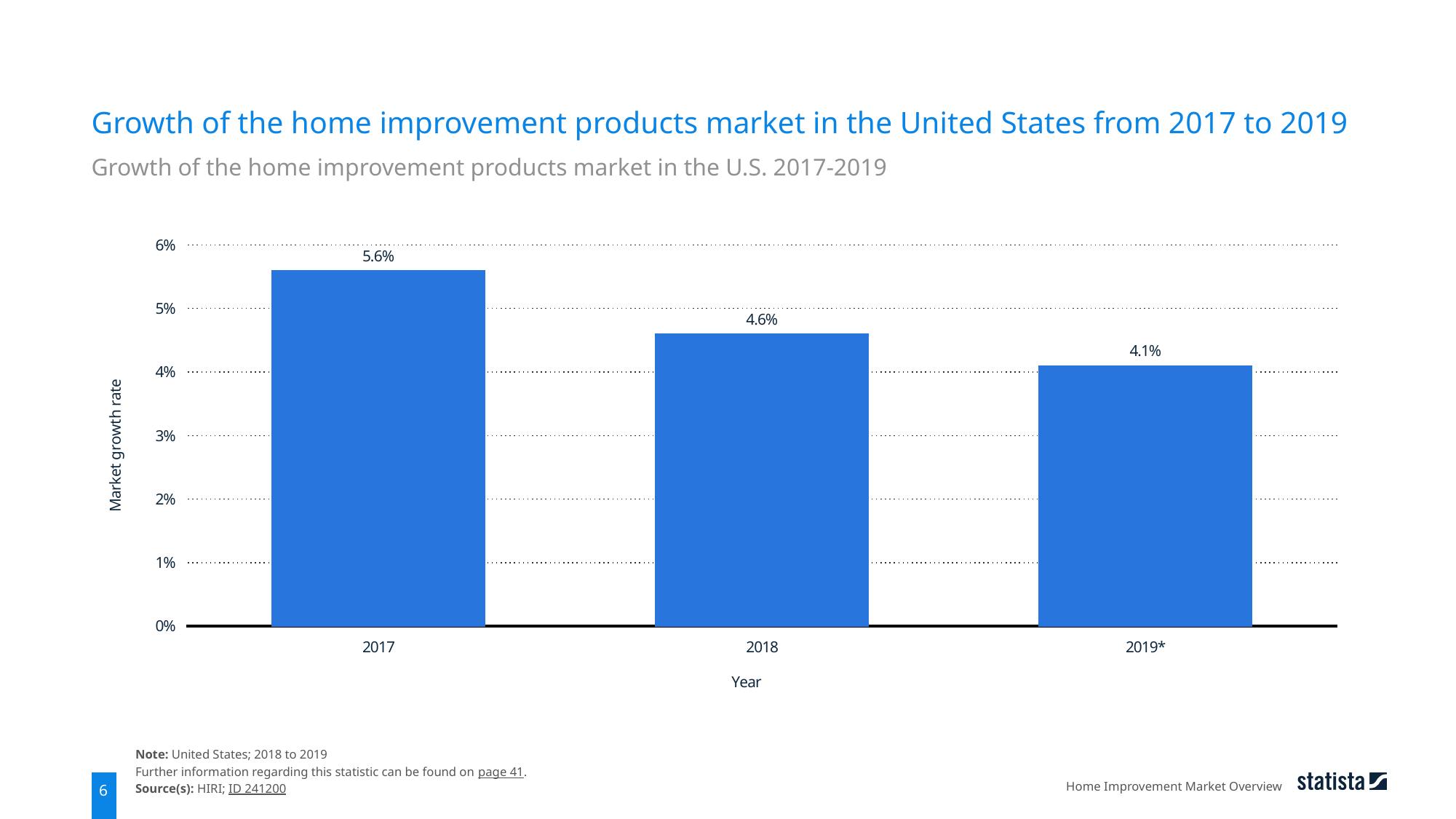
What was the market growth rate in 2018? 4.6% Which year had the highest market growth rate? 2017 Is the market growth rate for 2017 greater or less than 5%? greater How many years are shown on the chart? 3 What was the market growth rate in 2019*? 4.1% Which year had a higher market growth rate, 2018 or 2019*? 2018 What is the difference in market growth rate between 2018 and 2019*? 0.5 percentage points What was the market growth rate in 2017? 5.6% What kind of chart is shown on the slide? Bar chart What is the difference in market growth rate between 2017 and 2018? 1 percentage point Which year had the lowest market growth rate? 2019* Does the market growth rate rise or fall from 2017 to 2019*? Fall